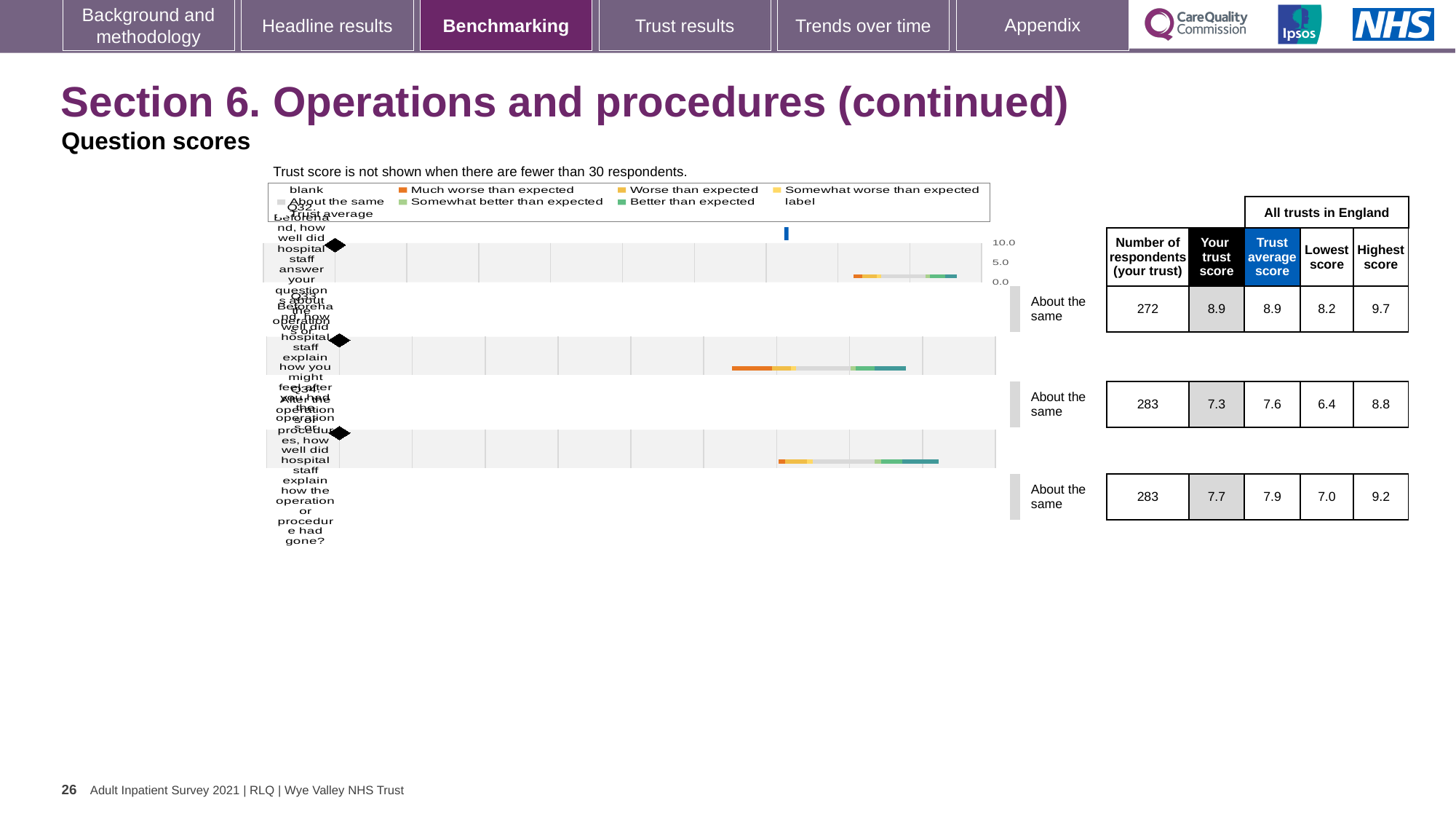
What is the highest score across all trusts in England for the first question row (Q32)? 9.7 What kind of chart is used to show the question scores on this slide? bar chart What is the lowest score across all trusts in England for the second question row (Q33)? 6.4 What is the difference between the highest score and the lowest score for the third question row (Q34)? 2.2 Which of the three question rows has the lowest trust score? Q33 What is the trust average score for the third question row (Q34)? 7.9 Is the trust score for the second question row (Q33) larger or smaller than the trust average score for that row? smaller What is the trust score for the second question row (Q33)? 7.3 How many question rows are plotted in the benchmarking chart? 3 Which of the three question rows has the highest trust score? Q32 What is the number of respondents for the first question row (Q32) in the table beside the chart? 272 What benchmark category is shown for each of the three question rows? About the same